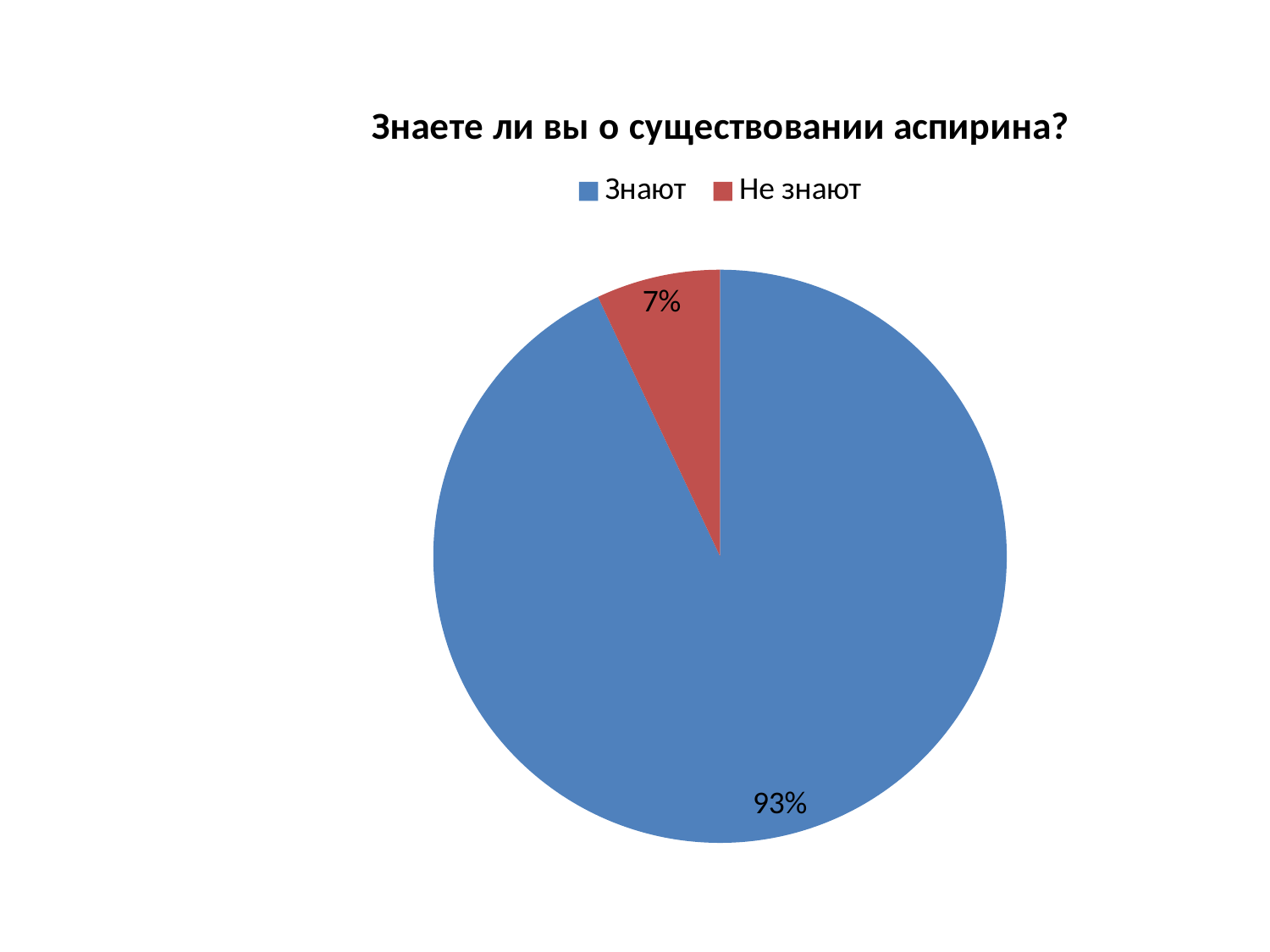
What is the title of the chart? Знаете ли вы о существовании аспирина? What colour is the "Не знают" slice? red Which category has the smallest slice of the pie? Не знают Which slice is larger, "Знают" or "Не знают"? Знают What share of the pie does the "Не знают" slice represent? 7% What share of the pie does the "Знают" slice represent? 93% How many entries does the legend list? 2 How many slices does the pie chart have? 2 What is the difference in percentage points between the "Знают" and "Не знают" slices? 86 What kind of chart is shown on the slide? pie chart Which category has the largest slice of the pie? Знают